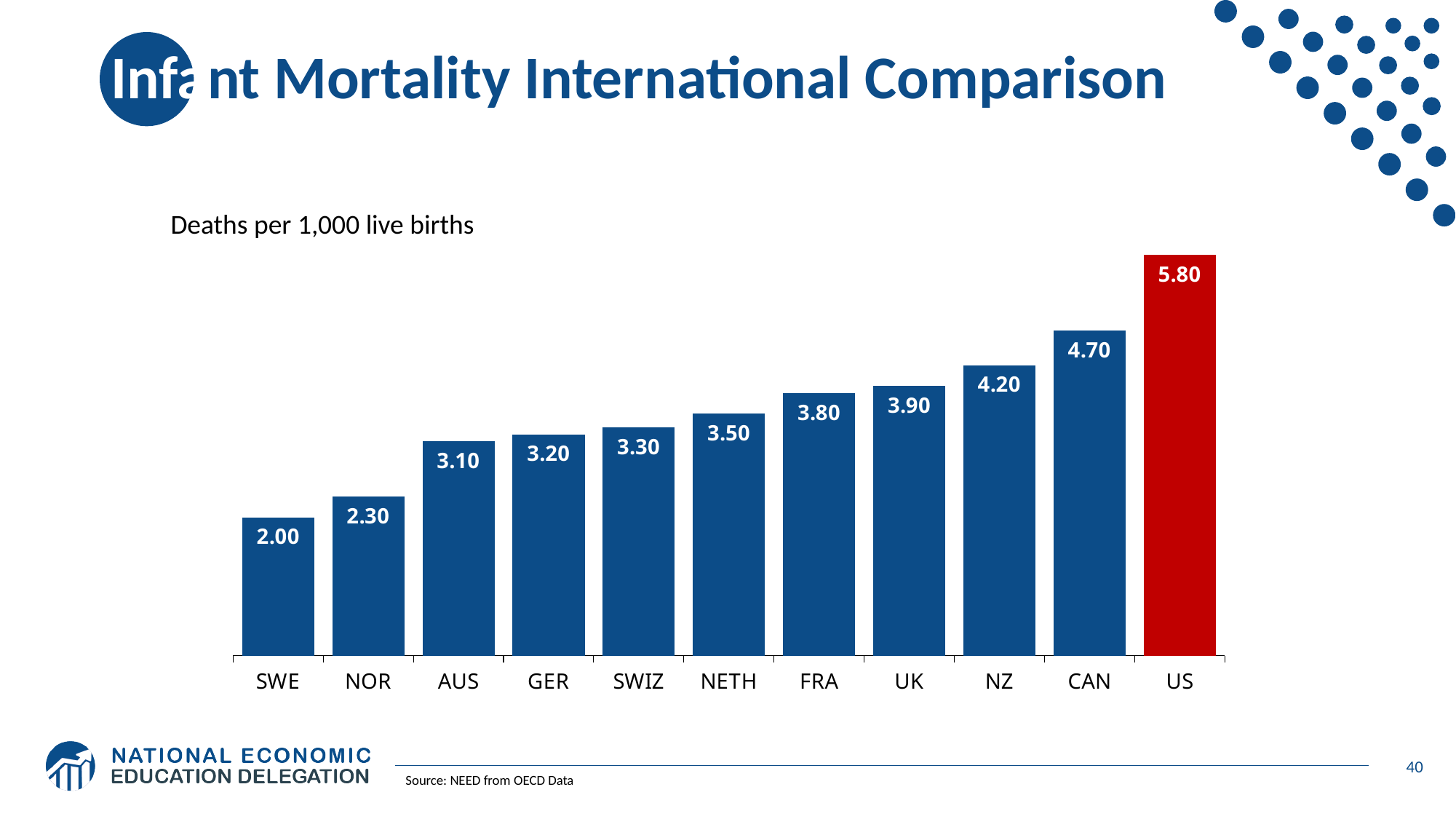
Which country has the highest infant mortality rate on the chart? US What is the difference between the values for US and CAN? 1.10 What is the value shown for NETH? 3.50 What is the difference between the values for NOR and SWE? 0.30 Which bar is coloured red instead of blue? US How many countries are shown on the chart? 11 What type of chart is shown on the slide? Bar chart Which has a higher value, NZ or UK? NZ What is the infant mortality value for the US? 5.80 What is the value shown for GER? 3.20 Which country has the lowest infant mortality rate on the chart? SWE Do the values rise or fall moving from left to right along the x axis? Rise